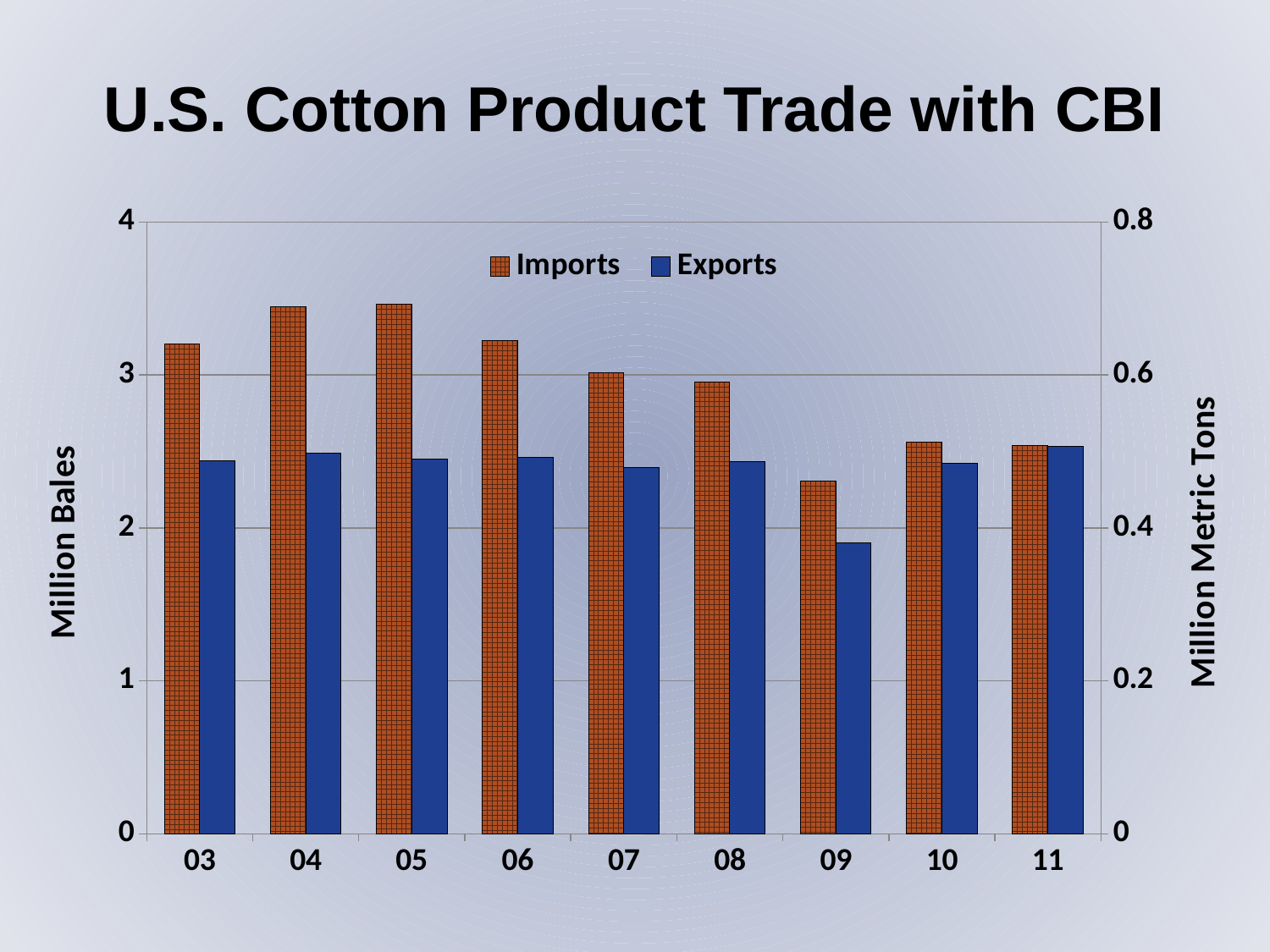
Is the Imports value for 03 greater or less than 3 million bales? greater Is the Exports value for 09 greater or less than 2 million bales? less What is the label on the right-hand vertical axis? Million Metric Tons How many years are shown on the x axis? 9 How many series does the legend list? 2 Is the Imports value for 09 greater or less than 2 million bales? greater Which year has the lowest Imports value? 09 In 03, which is larger, Imports or Exports? Imports Which year has the lowest Exports value? 09 What kind of chart is shown on the slide? bar chart Do the Imports values rise or fall from 05 to 09? fall